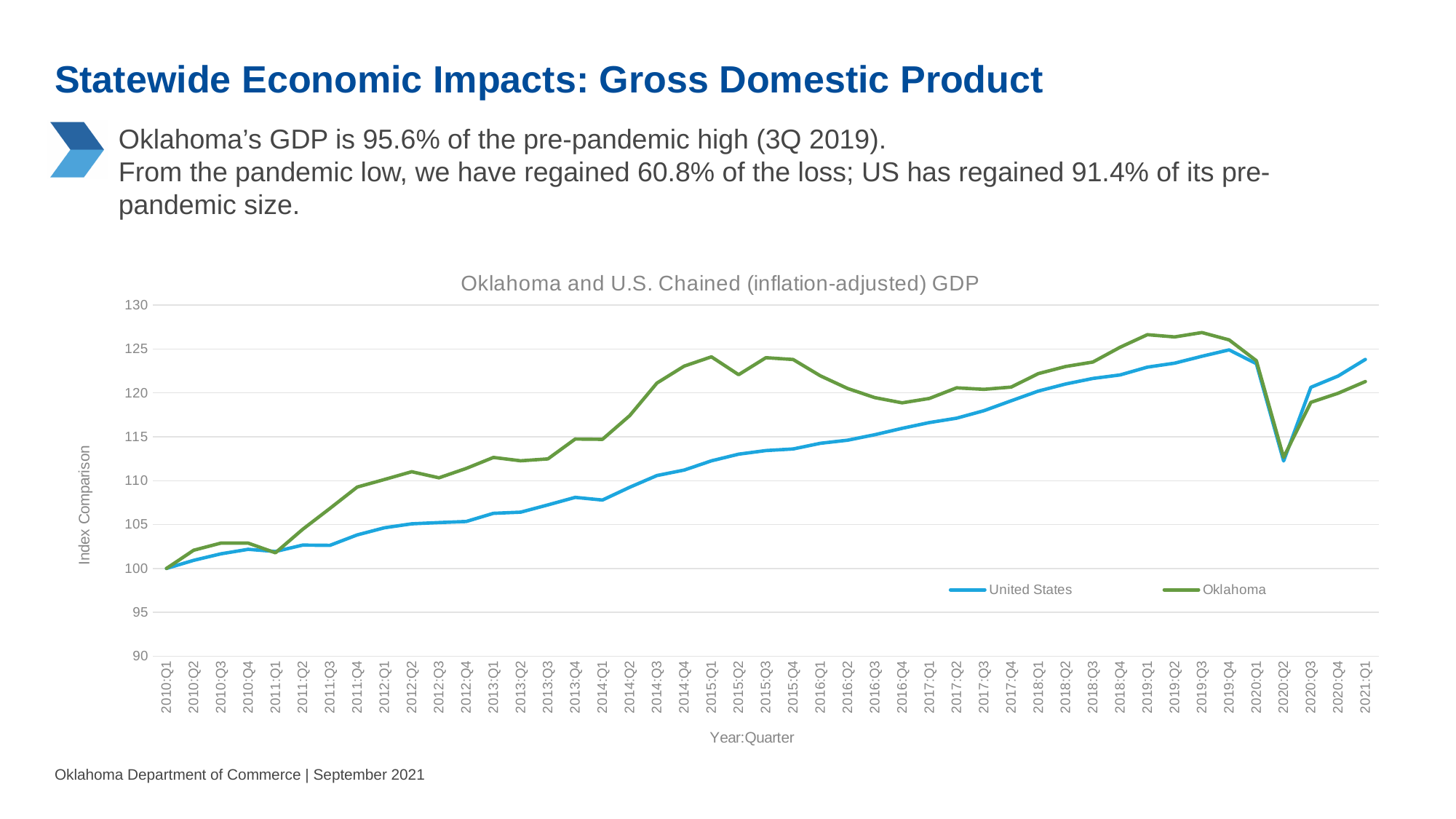
Is the United States value at 2020:Q2 greater or less than 110? greater What kind of chart is shown on the slide? line chart Is the Oklahoma value at 2015:Q1 greater or less than 120? greater Which colour is used for the Oklahoma line? green At 2021:Q1, which series has the higher value, United States or Oklahoma? United States Is the Oklahoma value at 2016:Q4 greater or less than 120? less What is the index value for the United States at 2010:Q1? 100 At which quarter is the Oklahoma line at its lowest value? 2010:Q1 What is the title of the chart? Oklahoma and U.S. Chained (inflation-adjusted) GDP At 2015:Q1, which series has the higher value, United States or Oklahoma? Oklahoma How many series does the chart's legend list? 2